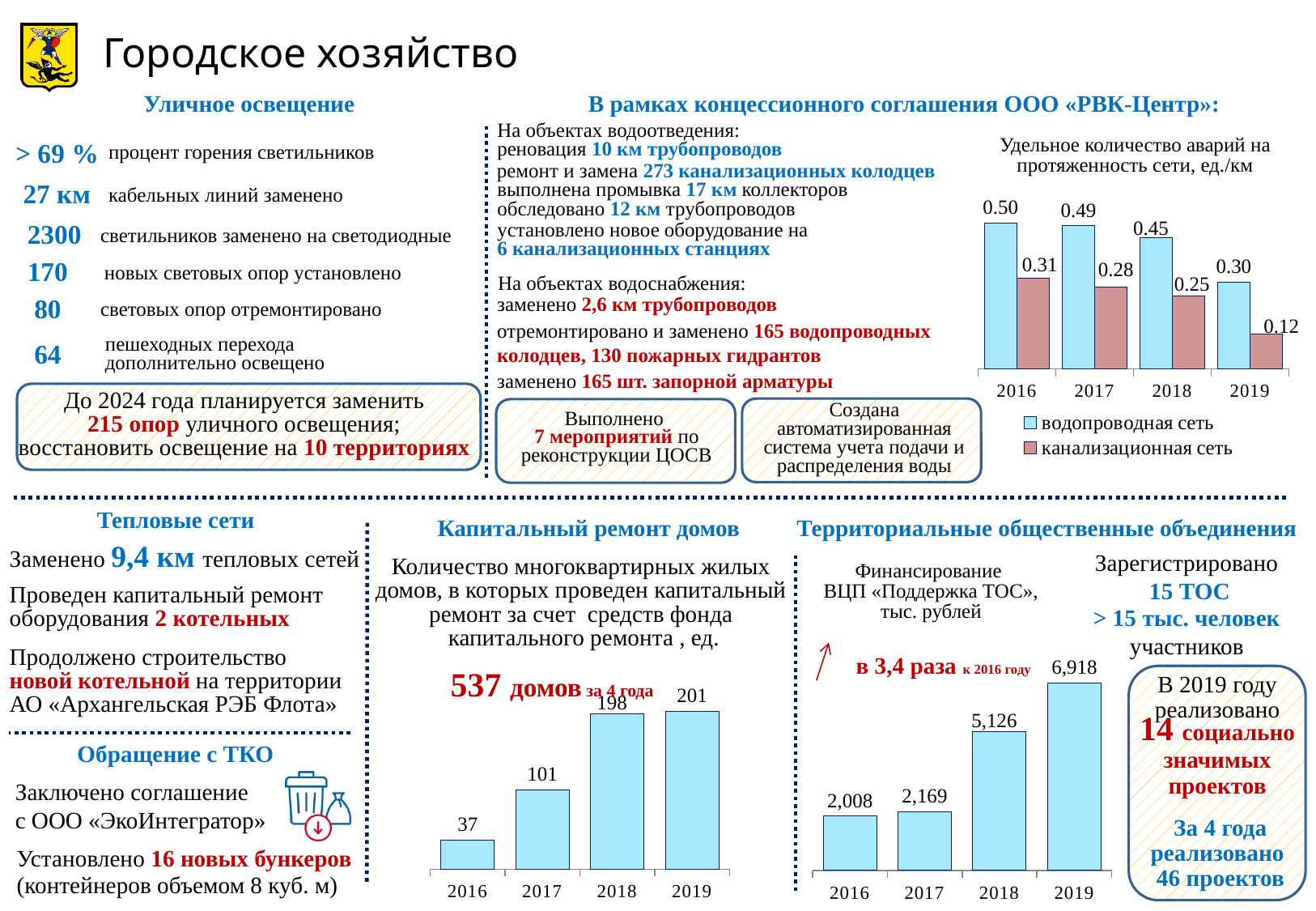
In the chart 'Удельное количество аварий на протяженность сети, ед./км', how many series does the legend list? 2 In the chart 'Количество многоквартирных жилых домов, в которых проведен капитальный ремонт', what is the difference between 2018 and 2016? 161 In the chart 'Количество многоквартирных жилых домов, в которых проведен капитальный ремонт', how many years are shown on the x axis? 4 In the chart 'Количество многоквартирных жилых домов, в которых проведен капитальный ремонт', which year has the lowest value? 2016 What type of chart is 'Финансирование ВЦП «Поддержка ТОС», тыс. рублей'? bar chart In the chart 'Удельное количество аварий на протяженность сети, ед./км', do the values for водопроводная сеть rise or fall from 2016 to 2019? fall In the chart 'Удельное количество аварий на протяженность сети, ед./км', what is the difference between водопроводная сеть and канализационная сеть in 2018? 0.20 In the chart 'Количество многоквартирных жилых домов, в которых проведен капитальный ремонт', what is the value for 2017? 101 In the chart 'Финансирование ВЦП «Поддержка ТОС», тыс. рублей', what is the value for 2019? 6,918 In the chart 'Финансирование ВЦП «Поддержка ТОС», тыс. рублей', which year has the highest value? 2019 In the chart 'Удельное количество аварий на протяженность сети, ед./км', what is the value for канализационная сеть in 2019? 0.12 In the chart 'Удельное количество аварий на протяженность сети, ед./км', what is the value for водопроводная сеть in 2016? 0.50